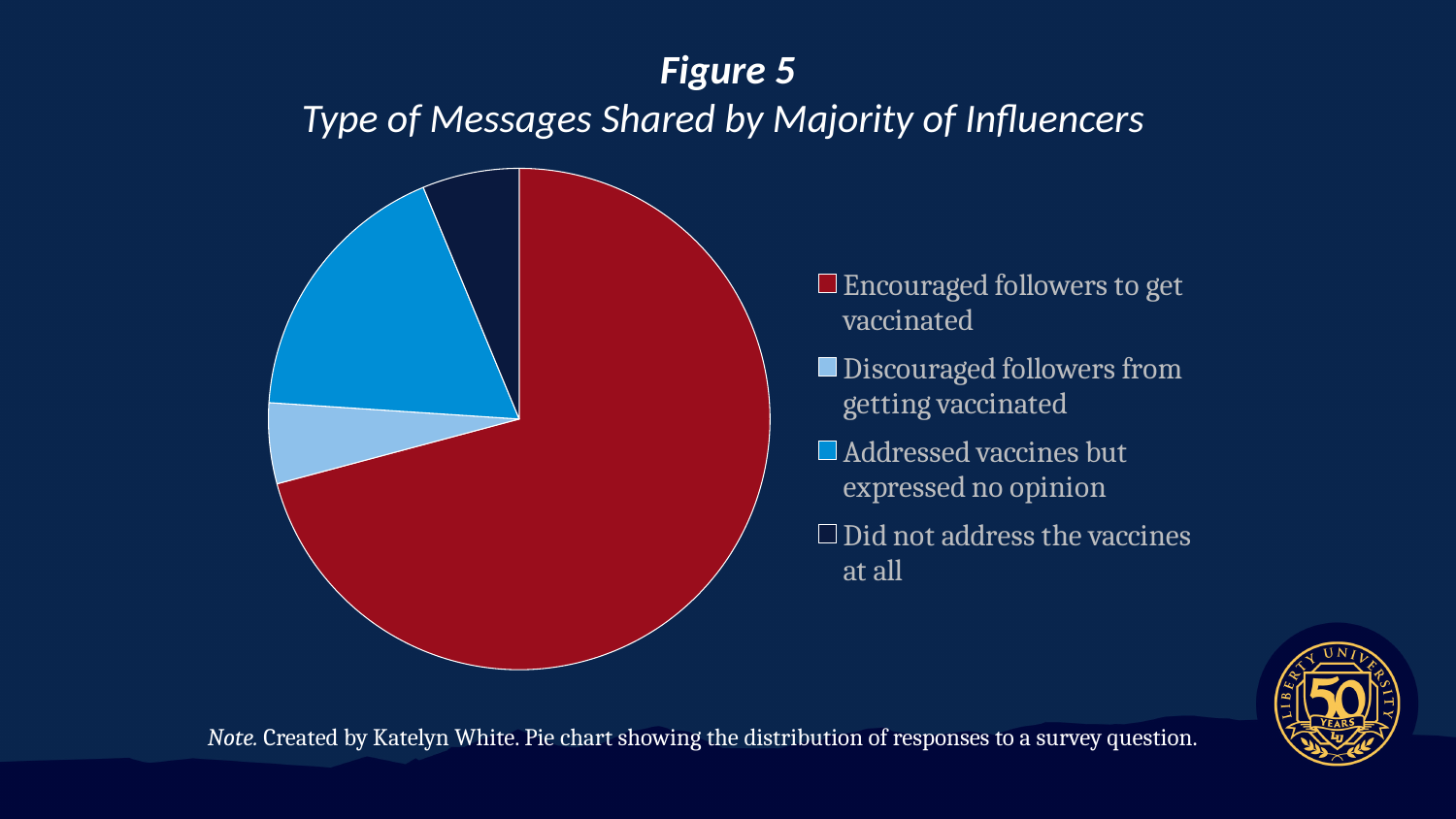
What colour represents "Encouraged followers to get vaccinated" in the pie chart? Red What is the title of the chart? Type of Messages Shared by Majority of Influencers Which slice is larger: "Addressed vaccines but expressed no opinion" or "Discouraged followers from getting vaccinated"? Addressed vaccines but expressed no opinion How many entries does the legend list? 4 Which slice is larger: "Encouraged followers to get vaccinated" or "Addressed vaccines but expressed no opinion"? Encouraged followers to get vaccinated How many slices does the pie chart have? 4 Which category has the largest slice of the pie? Encouraged followers to get vaccinated What kind of chart is shown on the slide? Pie chart Which slice is larger: "Addressed vaccines but expressed no opinion" or "Did not address the vaccines at all"? Addressed vaccines but expressed no opinion